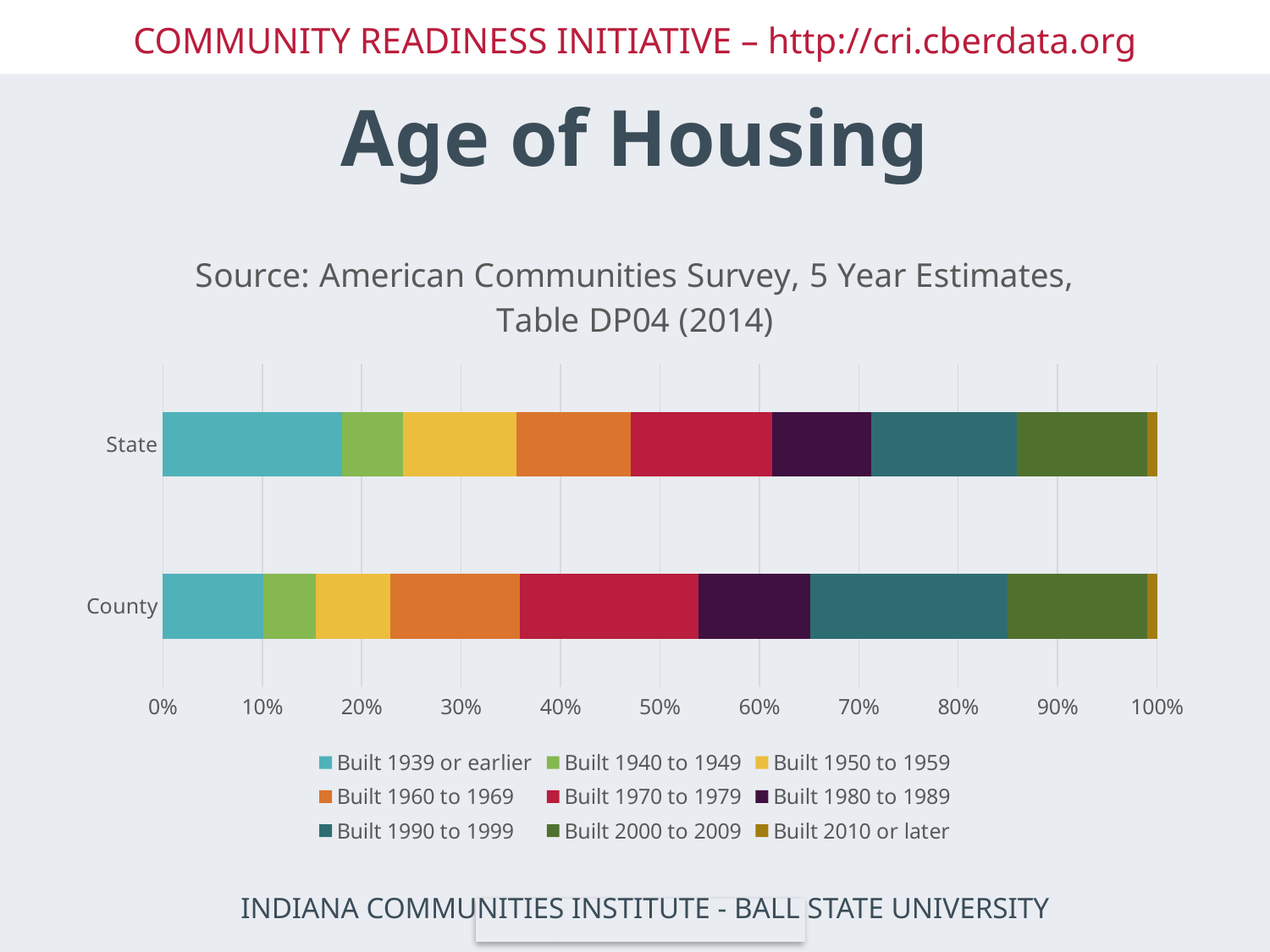
Which has a larger share of housing Built 1970 to 1979, State or County? County What kind of chart is shown on the slide? Stacked bar chart Which legend entry represents the oldest housing? Built 1939 or earlier Is the value for Built 1990 to 1999 in the County bar greater or less than 10%? greater How many categories (bars) does the chart show? 2 Is the value for Built 1939 or earlier in the State bar greater or less than 10%? greater What does each stacked bar total on the x axis? 100% Is the value for Built 1939 or earlier in the County bar greater or less than 20%? less How many series does the legend list? 9 Which has a larger share of housing Built 1939 or earlier, State or County? State What is the title of the chart? Age of Housing Which has a larger share of housing Built 1990 to 1999, State or County? County